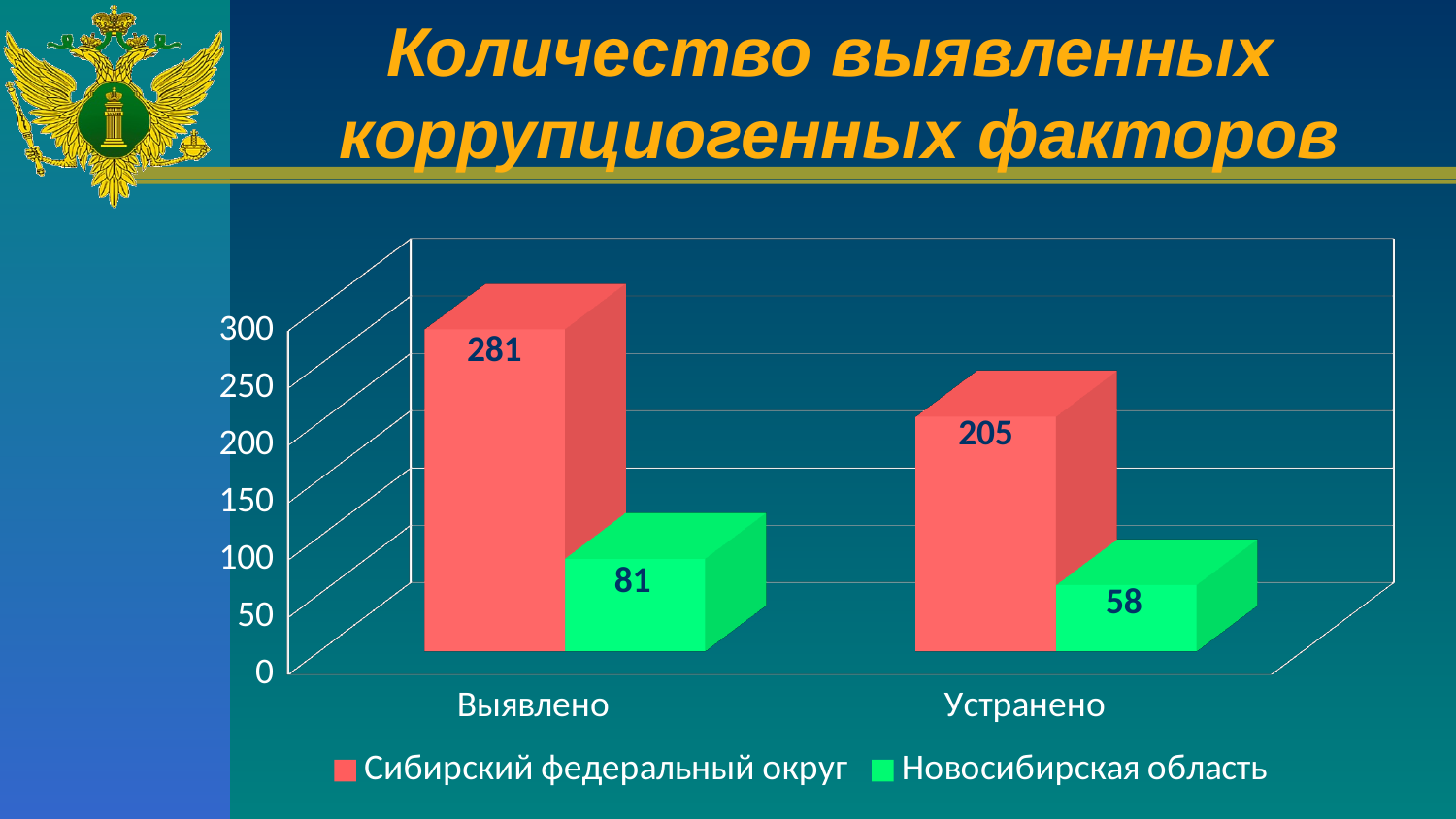
Which is larger: the Новосибирская область value for Выявлено or for Устранено? Выявлено What is the value for Новосибирская область in the Выявлено category? 81 What is the value for Сибирский федеральный округ in the Выявлено category? 281 How many series does the legend list? 2 What kind of chart is shown on the slide? Bar chart What is the difference between the Сибирский федеральный округ and Новосибирская область values in the Выявлено category? 200 What is the difference between the Сибирский федеральный округ values for Выявлено and Устранено? 76 What is the value for Сибирский федеральный округ in the Устранено category? 205 Which category has the highest value for Сибирский федеральный округ? Выявлено Which category has the lowest value for Новосибирская область? Устранено What is the value for Новосибирская область in the Устранено category? 58 How many categories are shown on the x axis? 2